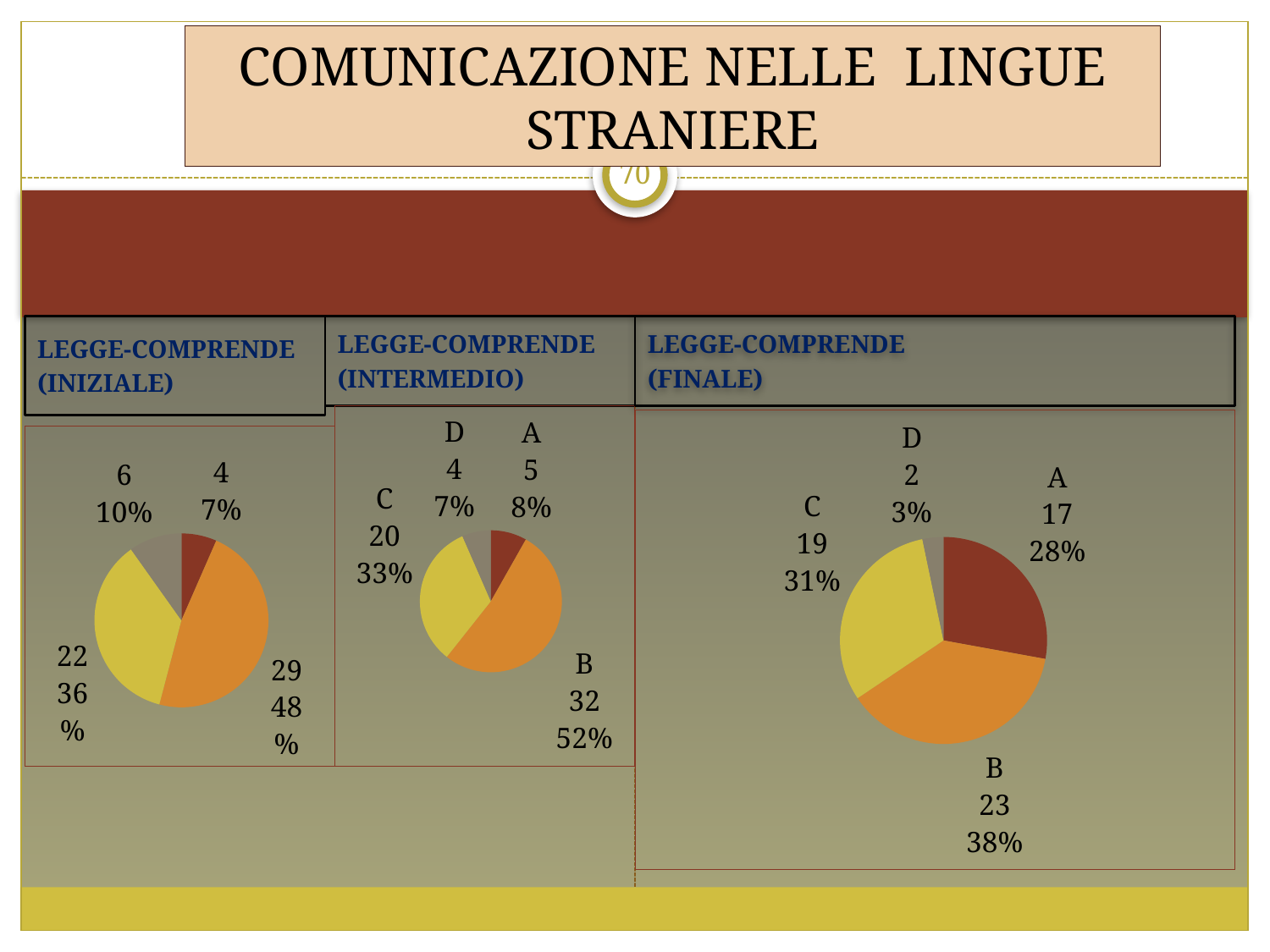
In the LEGGE-COMPRENDE (INTERMEDIO) chart, which category has the smallest slice? D In the LEGGE-COMPRENDE (INIZIALE) chart, what is the largest percentage shown? 48% In the LEGGE-COMPRENDE (INTERMEDIO) chart, what is the count for category C? 20 In the LEGGE-COMPRENDE (FINALE) chart, which category has the largest slice? B In the LEGGE-COMPRENDE (FINALE) chart, what percentage share does category A have? 28% In the LEGGE-COMPRENDE (FINALE) chart, what is the count for category B? 23 What type of chart is used for LEGGE-COMPRENDE (INTERMEDIO)? Pie chart In the LEGGE-COMPRENDE (INTERMEDIO) chart, what percentage share does category B have? 52% In the LEGGE-COMPRENDE (FINALE) chart, what is the difference between the counts for B and C? 4 How many slices does the LEGGE-COMPRENDE (FINALE) pie chart have? 4 In the LEGGE-COMPRENDE (INTERMEDIO) chart, which is larger, the count for A or the count for D? A How many charts are shown on the slide? 3